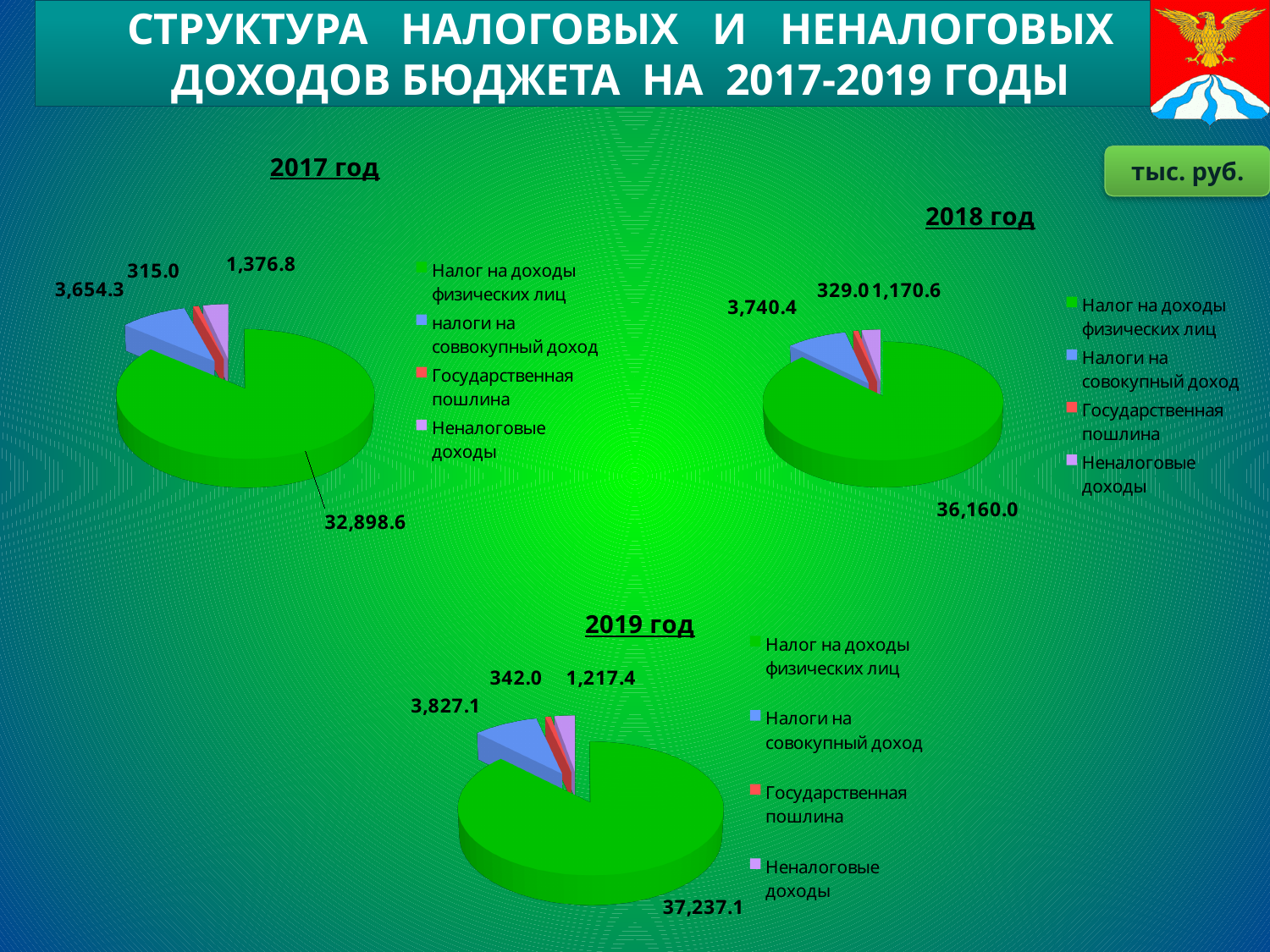
On the 2018 год chart, which category has the largest value? Налог на доходы физических лиц On the 2018 год chart, what is the value for Налоги на совокупный доход? 3,740.4 On the 2017 год chart, what is the difference between Налоги на совокупный доход and Государственная пошлина? 3,339.3 In what units are the values on the slide given? тыс. руб. On the 2019 год chart, what is the value for Государственная пошлина? 342.0 On the 2017 год chart, what is the value for Налог на доходы физических лиц? 32,898.6 On the 2017 год chart, which category has the smallest value? Государственная пошлина By how much does Налог на доходы физических лиц on the 2019 год chart exceed the same category on the 2018 год chart? 1,077.1 What kind of chart is used for 2017 год? Pie chart On the 2018 год chart, which is larger: Неналоговые доходы or Государственная пошлина? Неналоговые доходы How many slices does the 2019 год chart have? 4 On the 2019 год chart, what is the value for Неналоговые доходы? 1,217.4